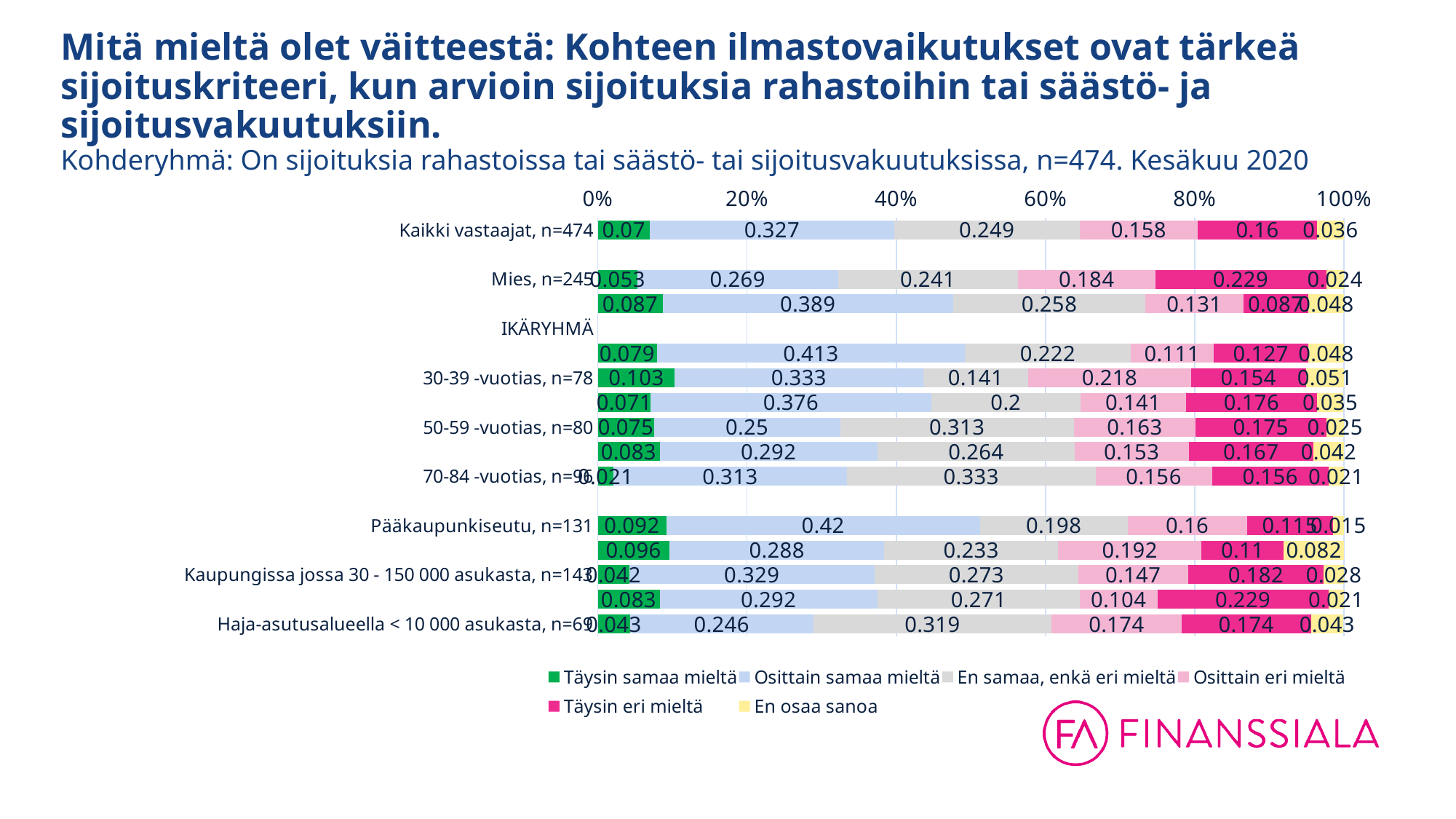
Which is larger: 'Täysin samaa mieltä' for '30-39 -vuotias, n=78' or for '70-84 -vuotias, n=96'? 30-39 -vuotias, n=78 What is the value of 'En samaa, enkä eri mieltä' for '70-84 -vuotias, n=96'? 0.333 What is the value of 'En osaa sanoa' for 'Haja-asutusalueella < 10 000 asukasta, n=69'? 0.043 What is the value of 'Täysin samaa mieltä' for 'Kaikki vastaajat, n=474'? 0.07 What is the difference between 'Osittain samaa mieltä' for 'Pääkaupunkiseutu, n=131' and for 'Haja-asutusalueella < 10 000 asukasta, n=69'? 0.174 What is the value of 'Osittain eri mieltä' for '30-39 -vuotias, n=78'? 0.218 What is the value of 'Osittain samaa mieltä' for 'Pääkaupunkiseutu, n=131'? 0.42 Which legend entry is shown in green? Täysin samaa mieltä What kind of chart is shown on the slide? stacked bar chart Which is larger: 'Täysin eri mieltä' for 'Kaupungissa jossa 30 - 150 000 asukasta, n=143' or for 'Pääkaupunkiseutu, n=131'? Kaupungissa jossa 30 - 150 000 asukasta, n=143 How many series does the legend list? 6 What is the value of 'Täysin eri mieltä' for 'Mies, n=245'? 0.229